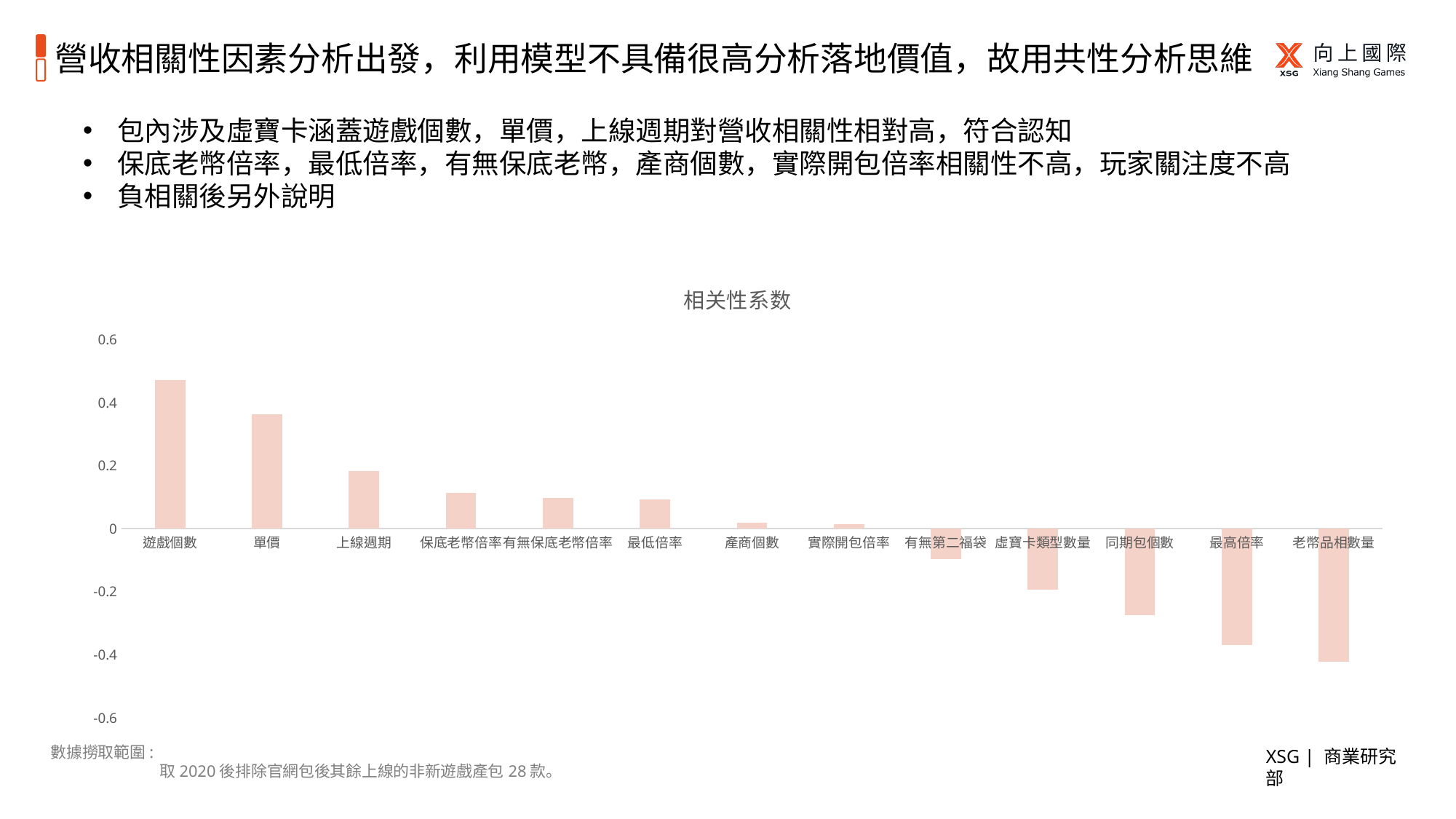
Which category has the lowest value in the chart? 老幣品相數量 Do the values generally rise or fall moving from left to right along the x axis? fall What is the title of the chart? 相关性系数 Which is larger, the value for 單價 or the value for 上線週期? 單價 Is the value for 同期包個數 greater or less than -0.2? less Is the value for 遊戲個數 greater or less than 0.4? greater How many categories are plotted in the chart? 13 Is the value for 老幣品相數量 greater or less than -0.4? less What kind of chart is shown on the slide? bar chart Which category has the highest value in the chart? 遊戲個數